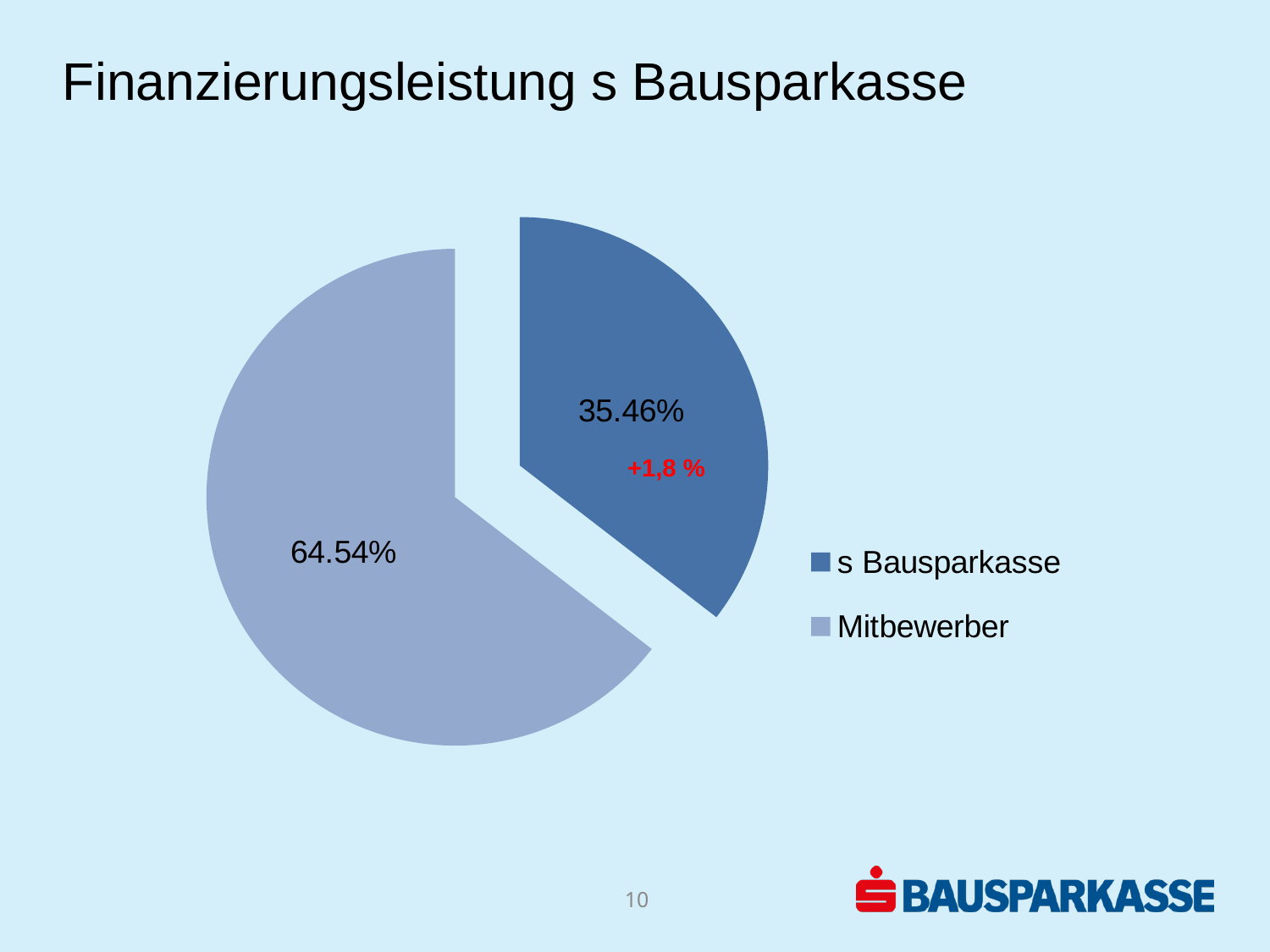
Which slice is the largest? Mitbewerber What is the share for s Bausparkasse? 35.46% How many entries does the legend list? 2 What is the title of the slide containing the chart? Finanzierungsleistung s Bausparkasse Which is larger, the share for s Bausparkasse or the share for Mitbewerber? Mitbewerber Which slice is the smallest? s Bausparkasse What is the difference between the Mitbewerber share and the s Bausparkasse share? 29.08% What kind of chart is shown on the slide? pie chart What change is shown in red text on the s Bausparkasse slice? +1,8 % How many slices does the pie chart have? 2 What is the share for Mitbewerber? 64.54% Is the share for s Bausparkasse greater or less than 50%? less